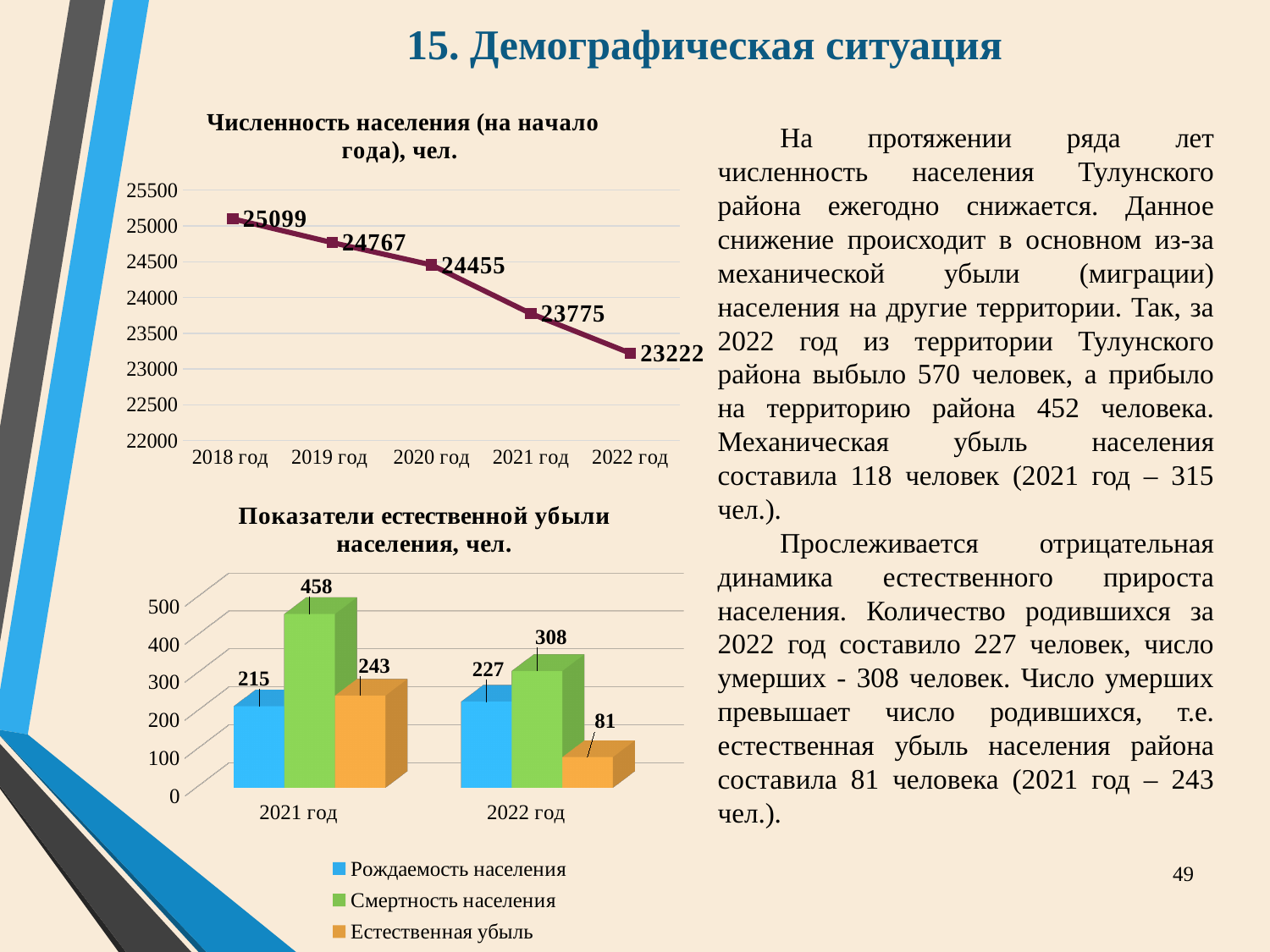
In the chart 'Показатели естественной убыли населения, чел.', what is the value of Естественная убыль for 2021 год? 243 In the chart 'Численность населения (на начало года), чел.', how many years are plotted? 5 In the chart 'Показатели естественной убыли населения, чел.', which is larger: Рождаемость населения in 2021 год or in 2022 год? 2022 год What kind of chart is 'Показатели естественной убыли населения, чел.'? bar chart In the chart 'Показатели естественной убыли населения, чел.', what is the difference between Смертность населения in 2021 год and 2022 год? 150 In the chart 'Численность населения (на начало года), чел.', what is the difference between the values for 2018 год and 2022 год? 1877 How many series does the legend of the chart 'Показатели естественной убыли населения, чел.' list? 3 What kind of chart is 'Численность населения (на начало года), чел.'? line chart In the chart 'Численность населения (на начало года), чел.', which year has the lowest population? 2022 год In the chart 'Численность населения (на начало года), чел.', do the values rise or fall from 2018 год to 2022 год? fall In the chart 'Показатели естественной убыли населения, чел.', what is the value of Смертность населения for 2022 год? 308 In the chart 'Численность населения (на начало года), чел.', what is the value for 2020 год? 24455